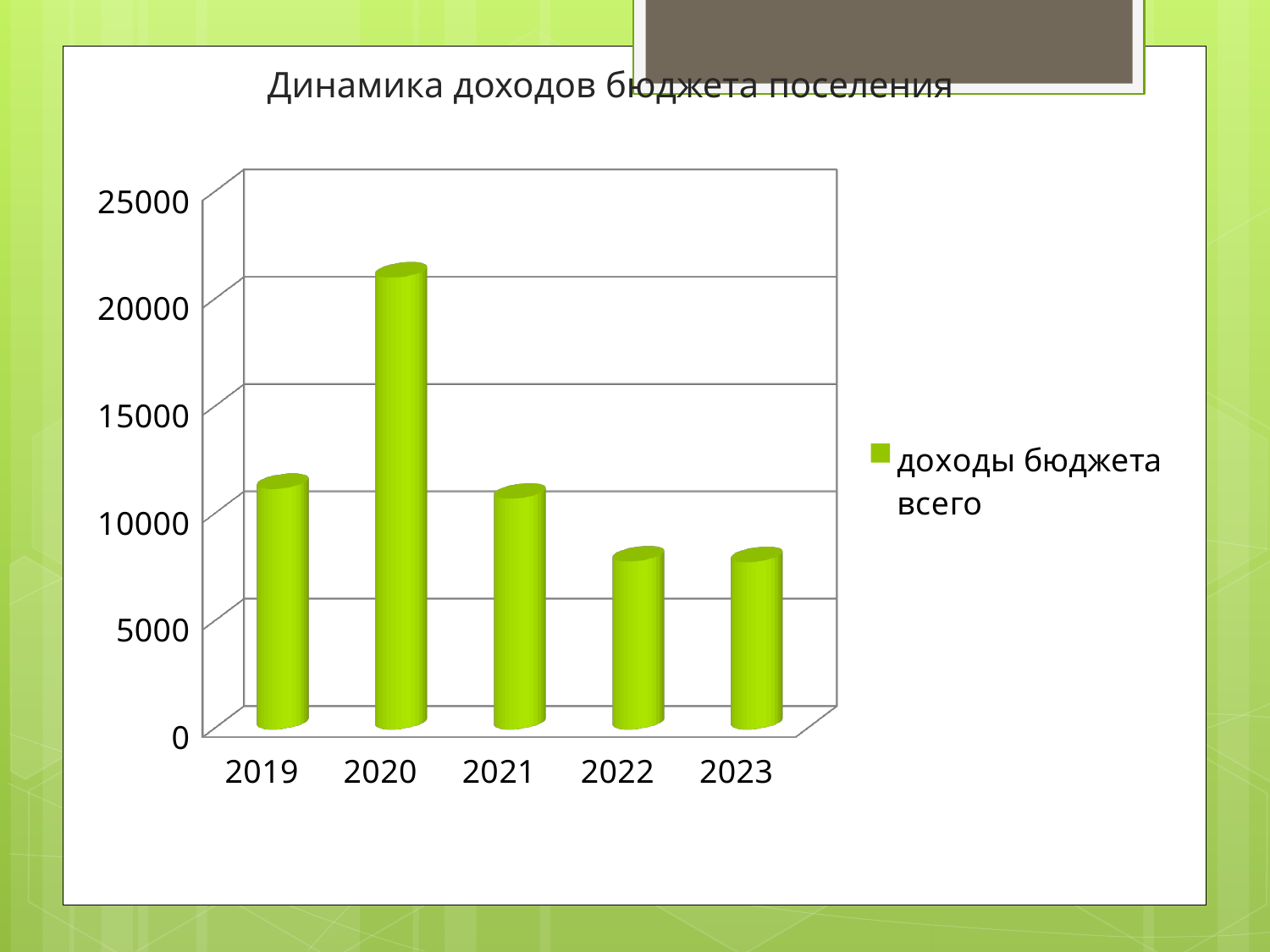
Is the value for 2022 greater or less than 10000? less What series name is listed in the chart legend? доходы бюджета всего Is the value for 2019 greater or less than 15000? less Which year has the highest value in the chart? 2020 Is the value for 2021 greater or less than 5000? greater What kind of chart is shown on the slide? bar chart From 2020 to 2022, do the values rise or fall? fall How many years are shown on the x axis of the chart? 5 Which is larger, the value for 2021 or the value for 2022? 2021 How many series does the legend list? 1 What is the title of the chart? Динамика доходов бюджета поселения